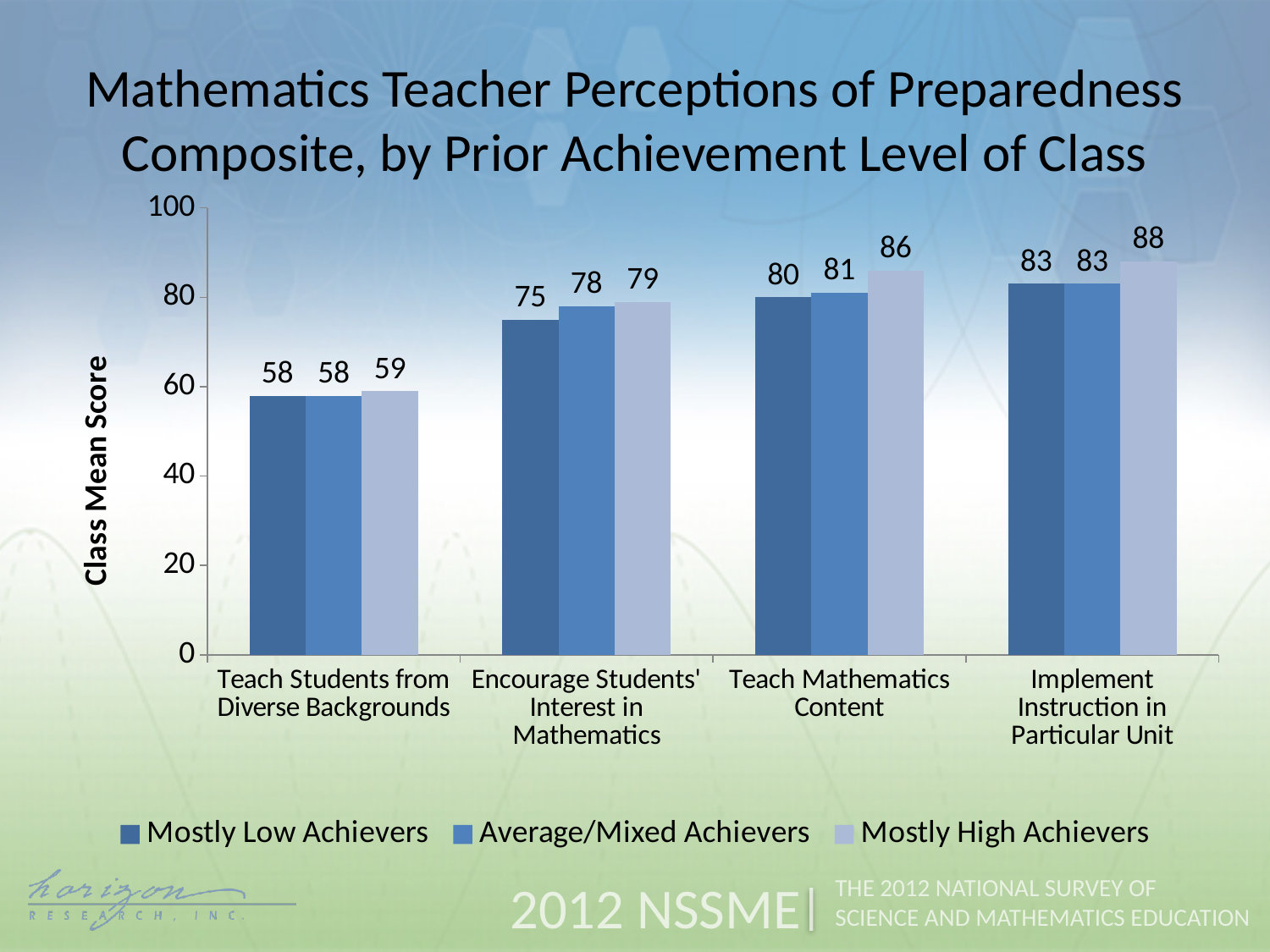
Which category has the lowest class mean score for Mostly Low Achievers? Teach Students from Diverse Backgrounds What is the difference between the Mostly High Achievers score for Implement Instruction in Particular Unit and for Teach Students from Diverse Backgrounds? 29 What is the class mean score for Average/Mixed Achievers on Implement Instruction in Particular Unit? 83 How many categories are shown on the x axis? 4 Which is larger: the Average/Mixed Achievers score for Encourage Students' Interest in Mathematics or for Teach Mathematics Content? Teach Mathematics Content Which category has the highest class mean score for Mostly High Achievers? Implement Instruction in Particular Unit What is the class mean score for Mostly High Achievers on Teach Mathematics Content? 86 How many series does the legend list? 3 What kind of chart is shown on the slide? Bar chart What is the difference between the Mostly High Achievers and Mostly Low Achievers scores for Teach Mathematics Content? 6 What is the label of the y axis? Class Mean Score What is the class mean score for Mostly Low Achievers on Encourage Students' Interest in Mathematics? 75